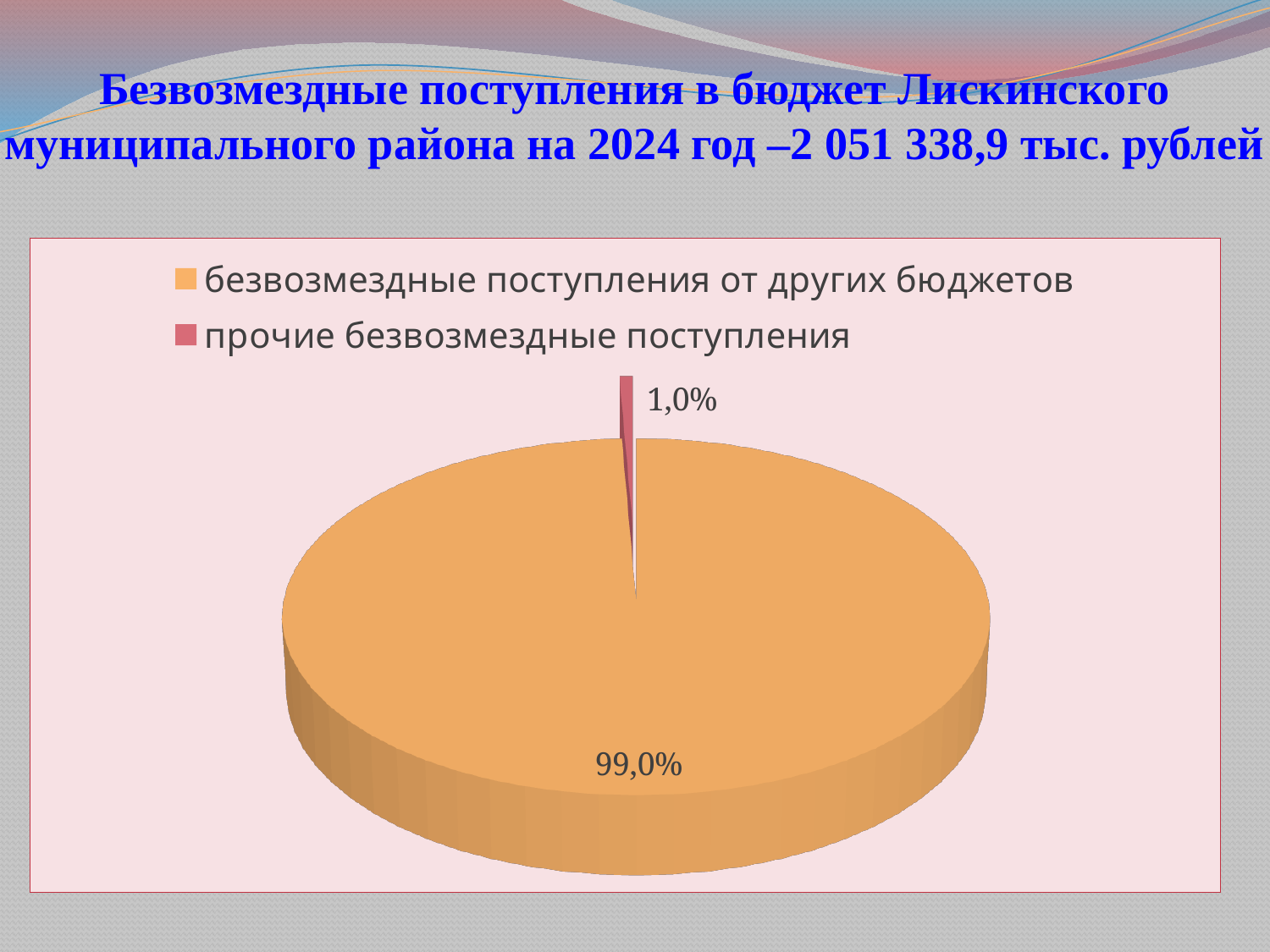
What share of the pie does "прочие безвозмездные поступления" take? 1,0% How many slices does the pie chart have? 2 How many entries does the legend list? 2 What share of the pie does "безвозмездные поступления от других бюджетов" take? 99,0% Which category has the smallest slice of the pie? прочие безвозмездные поступления What colour is the slice for "прочие безвозмездные поступления"? red Which is larger: the slice for "прочие безвозмездные поступления" or the slice for "безвозмездные поступления от других бюджетов"? безвозмездные поступления от других бюджетов What is the difference in percentage points between the two slices of the pie? 98,0% Which category has the largest slice of the pie? безвозмездные поступления от других бюджетов What total amount of gratuitous receipts for 2024 is stated in the slide title? 2 051 338,9 тыс. рублей What kind of chart is shown on the slide? pie chart